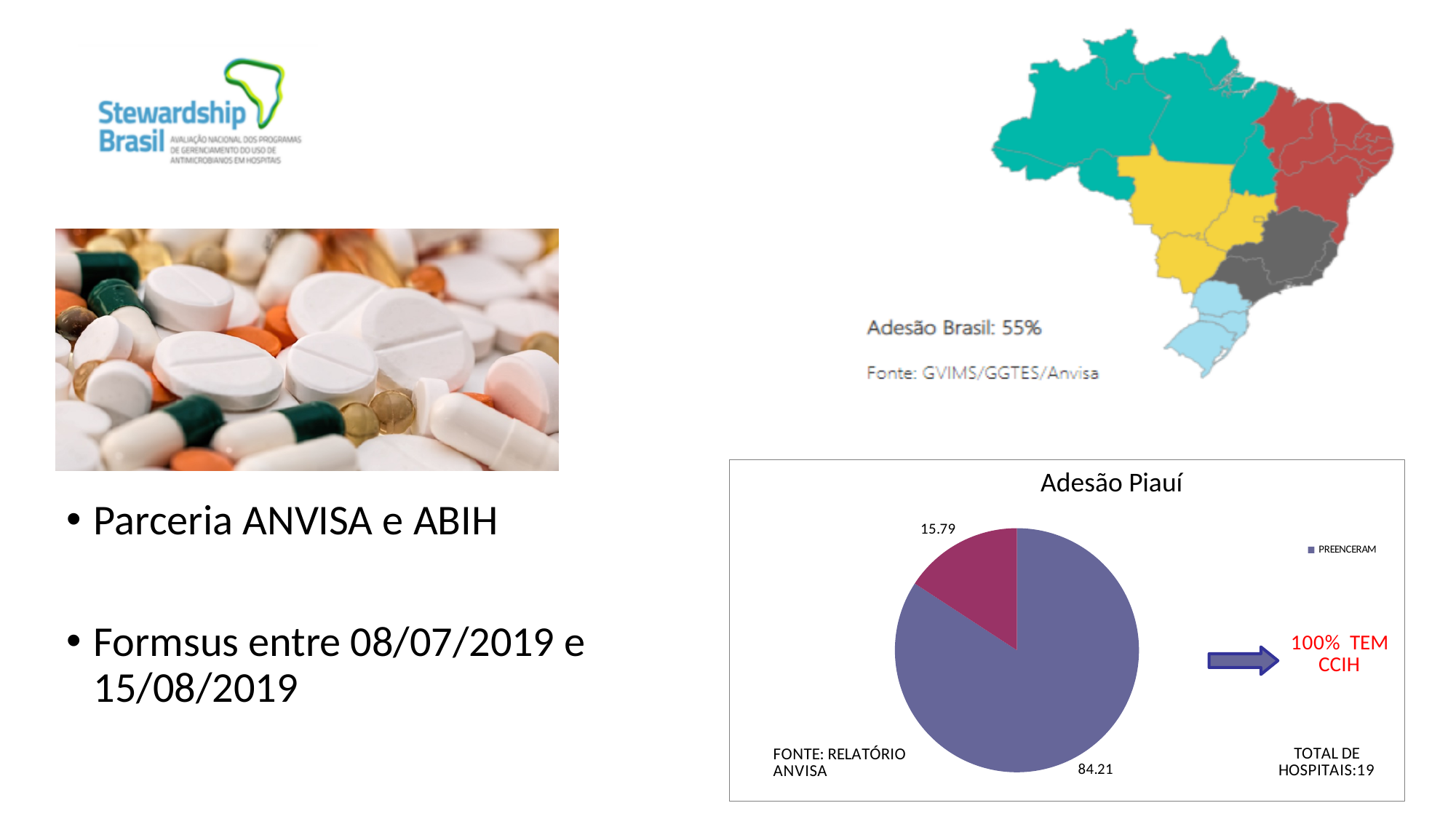
In the "Adesão Piauí" pie chart, what value is labelled on the larger slice? 84.21 In the "Adesão Piauí" pie chart, what is the sum of the two slice values? 100 In the "Adesão Piauí" pie chart, what is the smallest slice value? 15.79 In the "Adesão Piauí" pie chart, what value is labelled on the smaller slice? 15.79 What kind of chart is shown under the title "Adesão Piauí"? pie chart In the "Adesão Piauí" pie chart, what is the largest slice value? 84.21 In the "Adesão Piauí" pie chart, what is the value of the PREENCERAM slice? 84.21 How many slices does the "Adesão Piauí" pie chart have? 2 In the "Adesão Piauí" pie chart, what is the difference between the two slice values? 68.42 How many entries does the legend of the "Adesão Piauí" pie chart list? 1 In the "Adesão Piauí" pie chart, which slice is larger, the purple one or the magenta one? the purple one What is the title of the pie chart on the slide? Adesão Piauí